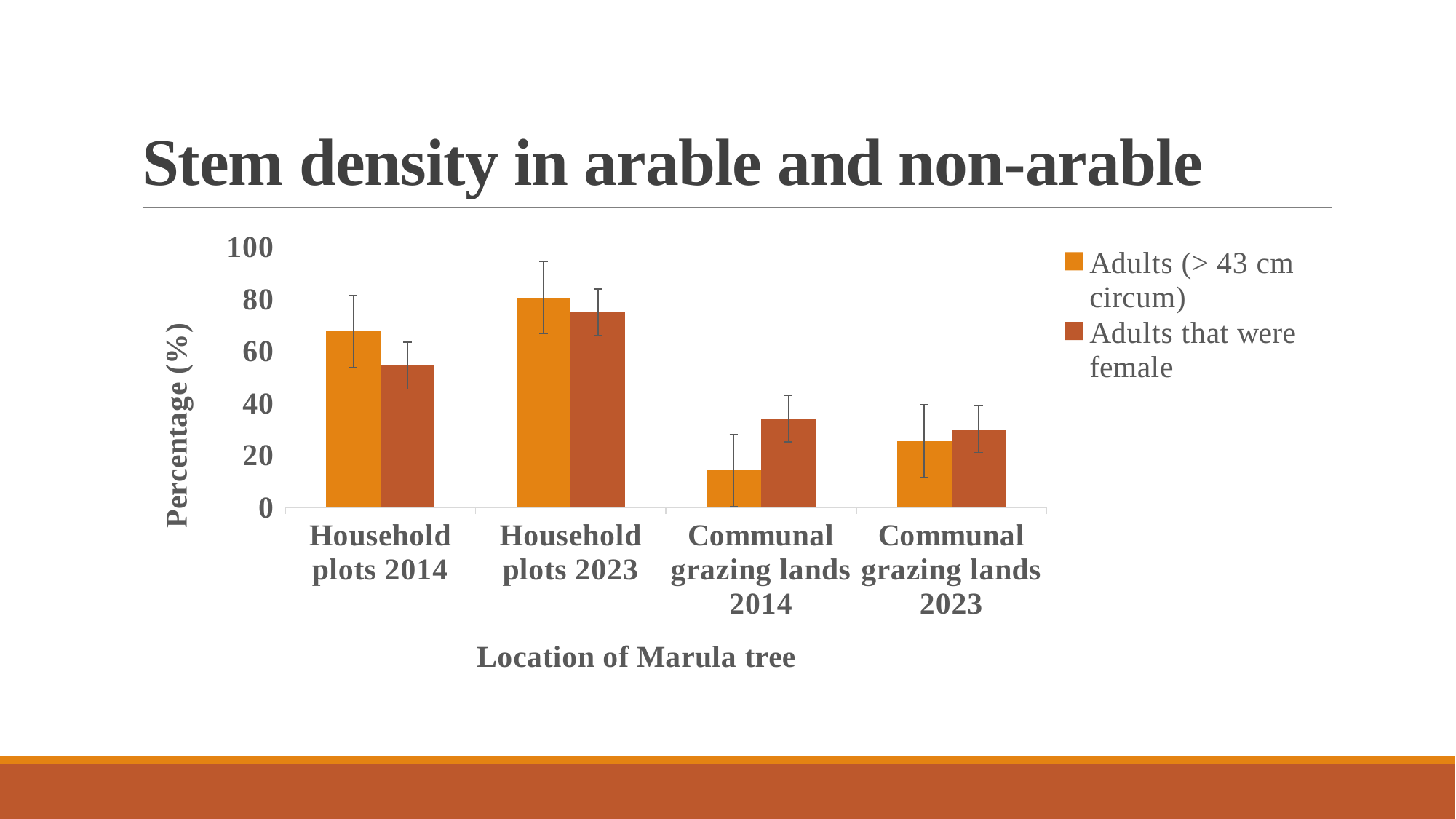
What kind of chart is shown on the slide? bar chart Which category has the lowest value for Adults (> 43 cm circum)? Communal grazing lands 2014 Is the value for Adults (> 43 cm circum) in Communal grazing lands 2014 greater or less than 20? less How many series does the legend list? 2 Which category has the highest value for Adults (> 43 cm circum)? Household plots 2023 Which category has the highest value for Adults that were female? Household plots 2023 What is the label of the x axis? Location of Marula tree How many location categories are shown on the x axis? 4 What is the label of the y axis? Percentage (%) In Household plots 2014, which series has the larger value: Adults (> 43 cm circum) or Adults that were female? Adults (> 43 cm circum) Is the value for Adults (> 43 cm circum) in Household plots 2023 greater or less than 60? greater In Communal grazing lands 2014, which series has the larger value: Adults (> 43 cm circum) or Adults that were female? Adults that were female